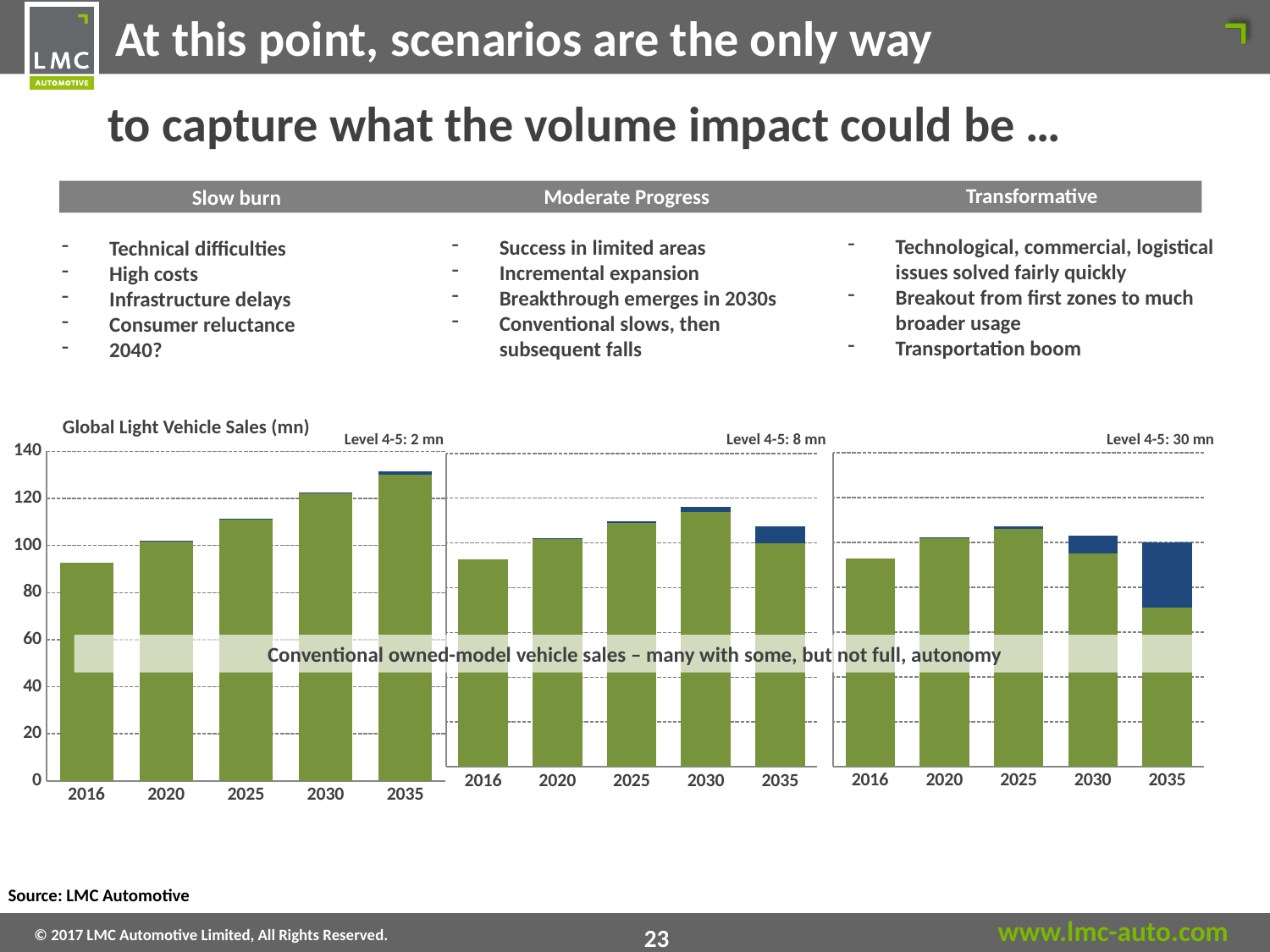
In the Slow burn chart, which year has the highest bar? 2035 In the Slow burn chart, is the value for 2035 greater or less than 120? greater Which is larger: the total bar for 2035 in the Slow burn chart or the total bar for 2035 in the Transformative chart? Slow burn 2035 How many years are shown on the x axis of the Slow burn chart? 5 What kind of chart is used in the Slow burn panel? bar chart In the Moderate Progress chart, is the value for 2016 greater or less than 100? less What is the title shown above the three charts? Global Light Vehicle Sales (mn) In the Transformative chart, is the green (conventional) portion of the 2035 bar greater or less than 80? less In the Slow burn chart, do the bars rise or fall from 2016 to 2035? rise In the Slow burn chart, which year has the lowest bar? 2016 What Level 4-5 volume is annotated above the Transformative chart? Level 4-5: 30 mn